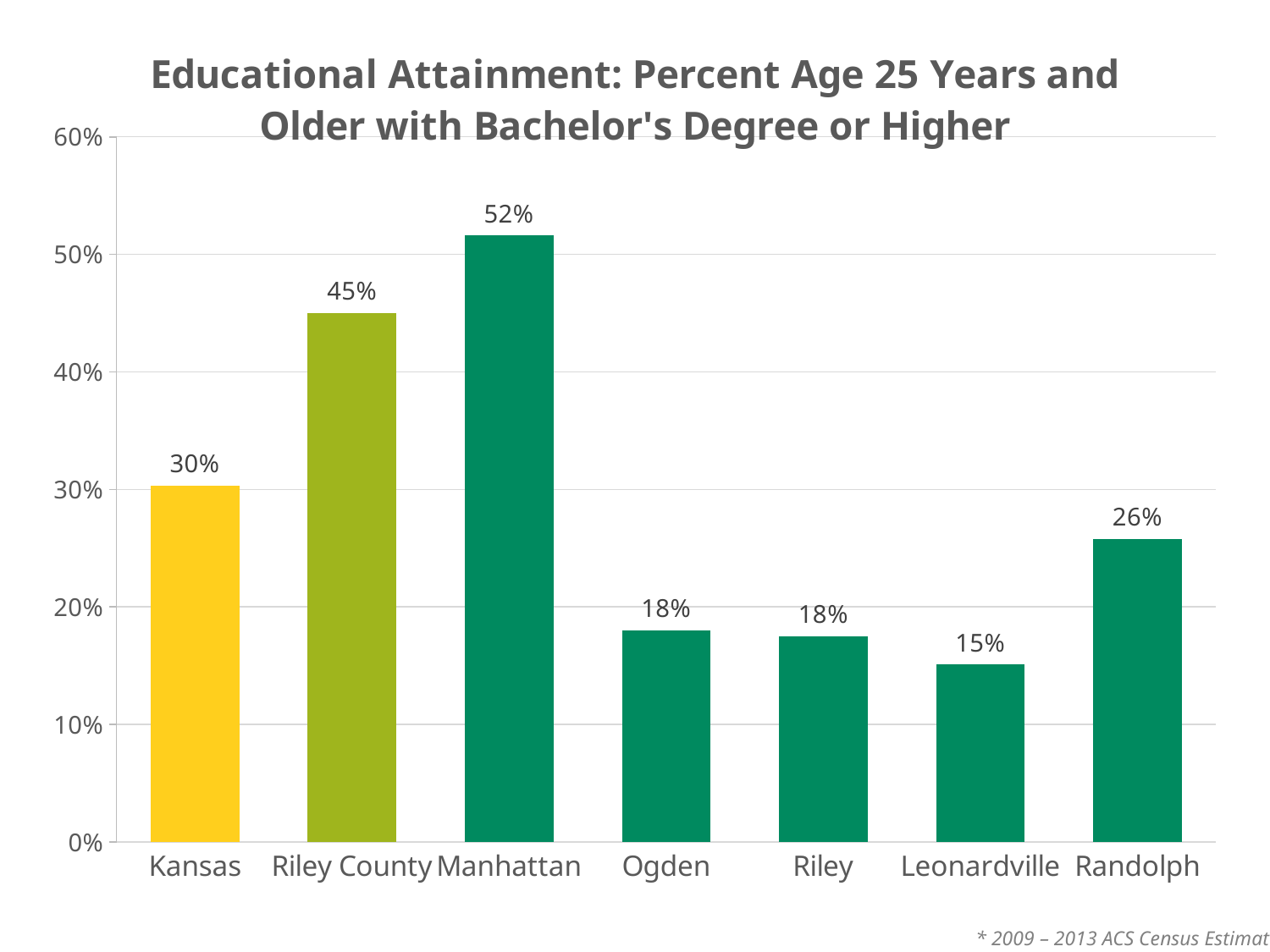
What is the difference between the values for Manhattan and Riley County? 7% What is the value for Manhattan? 52% Is the value for Riley County greater or less than 40%? greater What is the value for Randolph? 26% Which is larger, the value for Kansas or the value for Randolph? Kansas What is the value for Kansas? 30% How many categories are shown on the x axis? 7 Which category has the lowest value? Leonardville Which category has the highest value? Manhattan What is the value for Leonardville? 15% What kind of chart is shown on the slide? bar chart What colour is the bar for Kansas? yellow